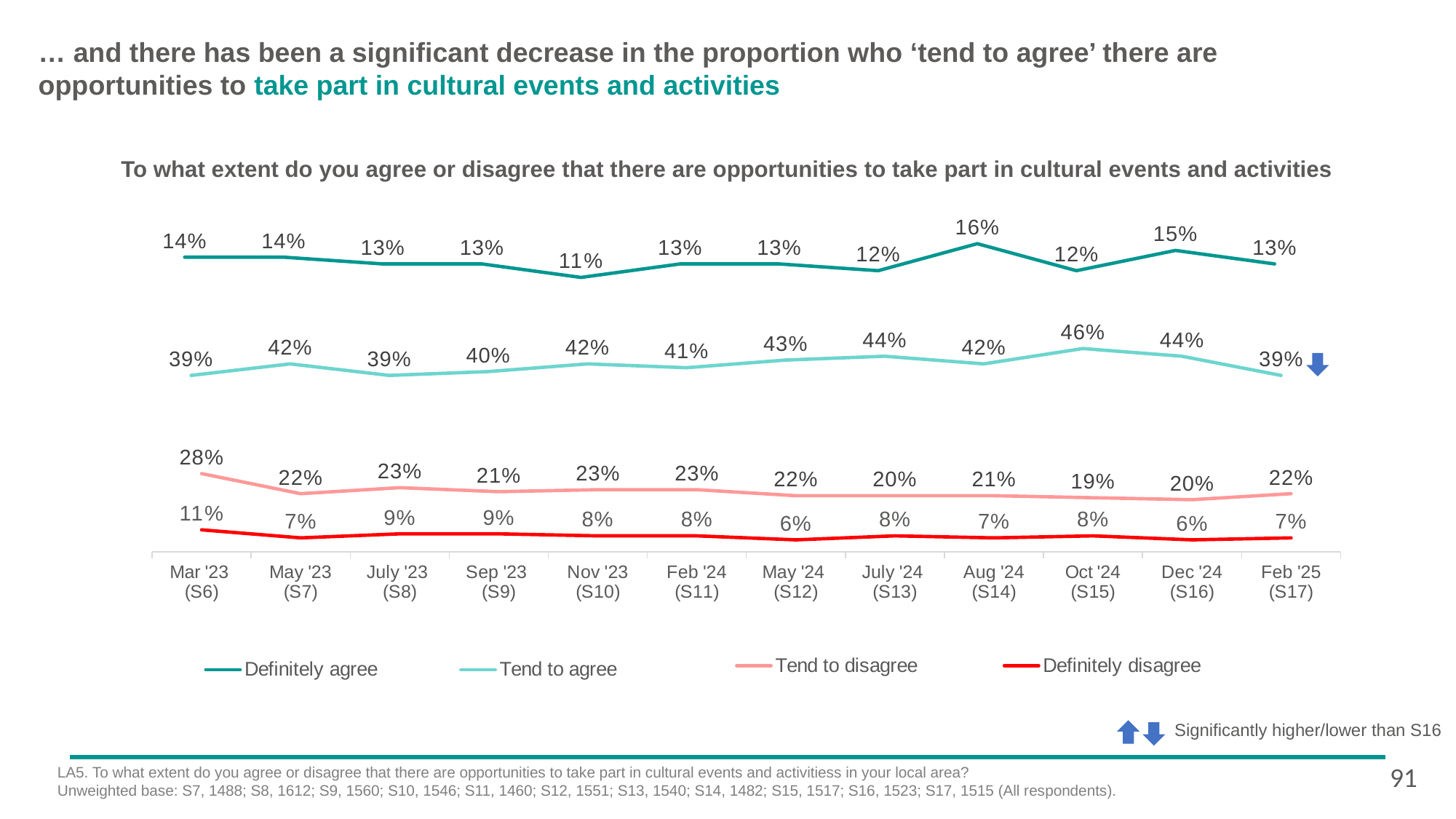
What is the value for 'Definitely agree' in Aug '24 (S14)? 16% What is the difference between the 'Tend to agree' values in Dec '24 (S16) and Feb '25 (S17)? 5 percentage points How many series does the legend list? 4 How many waves (time points) are shown on the x axis? 12 What is the value for 'Tend to agree' in Feb '25 (S17)? 39% What is the value for 'Tend to disagree' in Mar '23 (S6)? 28% Which series is shown with a red line in the legend? Definitely disagree What is the value for 'Definitely disagree' in Nov '23 (S10)? 8% In which wave is the 'Definitely agree' value lowest? Nov '23 (S10) Which is larger in Mar '23 (S6): 'Tend to disagree' or 'Definitely agree'? Tend to disagree What kind of chart is shown on the slide? Line chart In which wave is the 'Tend to agree' value highest? Oct '24 (S15)